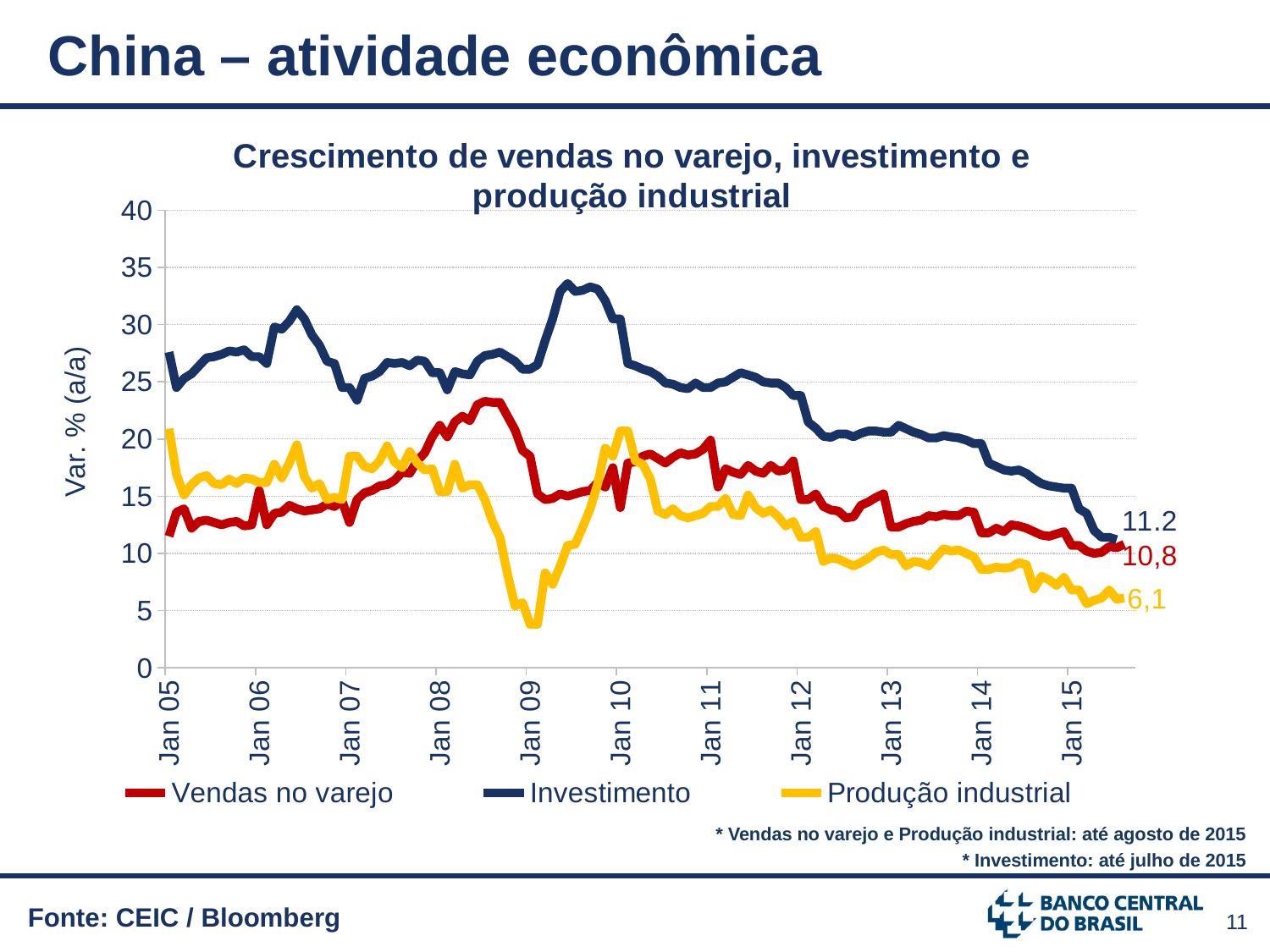
What is the label on the vertical axis? Var. % (a/a) Does the Investimento line rise or fall between Jan 12 and Jan 15? fall How many series does the legend list? 3 Is the peak value of Investimento in 2009 greater or less than 30? greater Which series has the lowest value at the end of the chart? Produção industrial Is the lowest value of Produção industrial in early 2009 greater or less than 5? less What kind of chart is shown on the slide? line chart What is the latest value shown for Vendas no varejo? 10,8 Which series has the highest value at the end of the chart? Investimento What is the difference between the latest values of Vendas no varejo and Produção industrial? 4,7 What is the latest value shown for Investimento? 11.2 What is the latest value shown for Produção industrial? 6,1